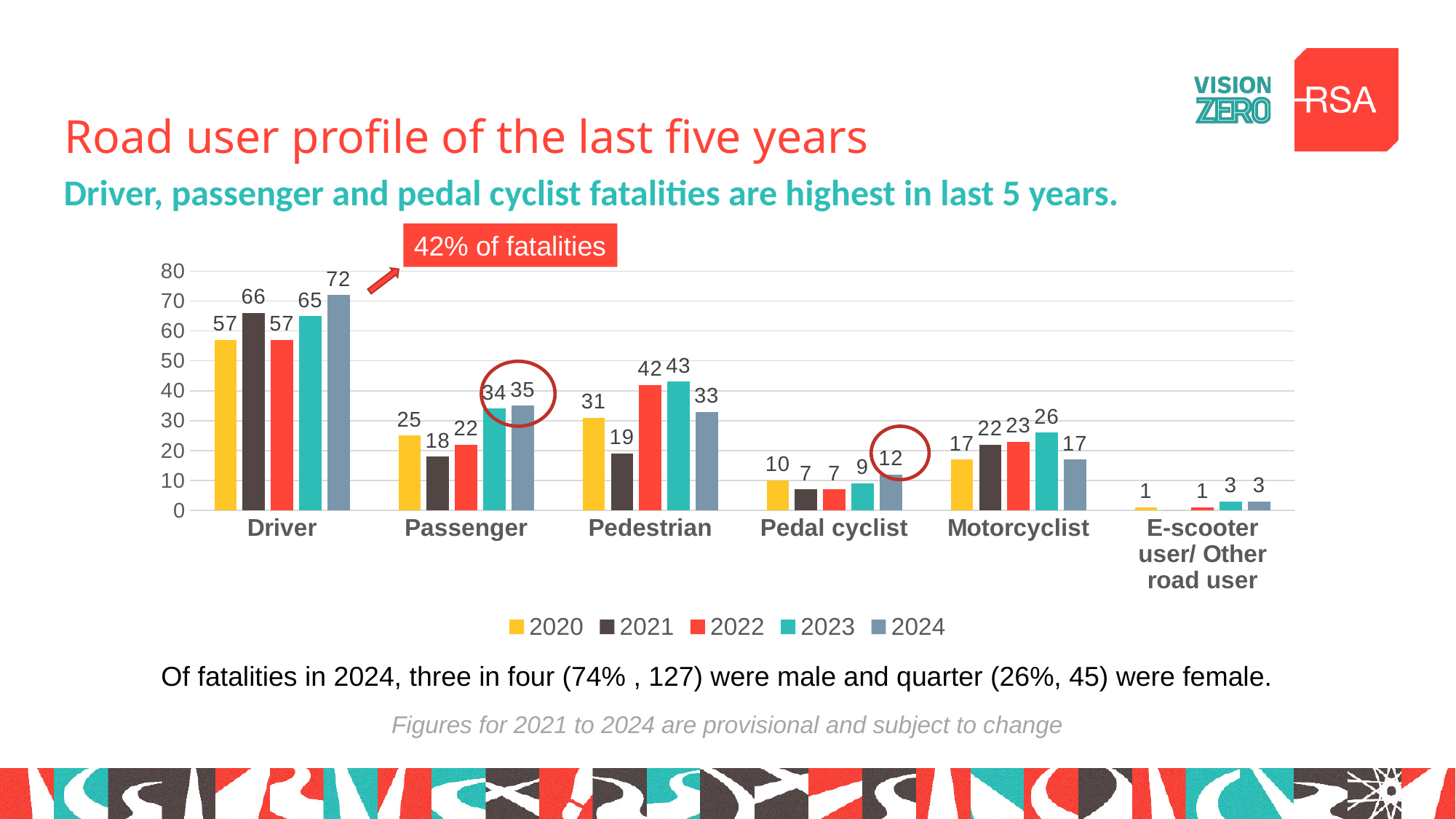
Which category has the lowest value in 2021? E-scooter user/ Other road user Which is larger: the Passenger value for 2023 or the Pedestrian value for 2024? Passenger value for 2023 Which category has the highest value in 2022? Driver What is the value for Pedestrian in 2023? 43 What does the red callout box above the Driver bars say? 42% of fatalities What is the difference between the Driver values for 2024 and 2020? 15 How many road user categories are shown on the x axis? 6 What is the value for Driver in 2024? 72 How many series does the legend list? 5 What kind of chart is shown on the slide? Bar chart What is the value for Motorcyclist in 2023? 26 What is the value for Pedal cyclist in 2020? 10